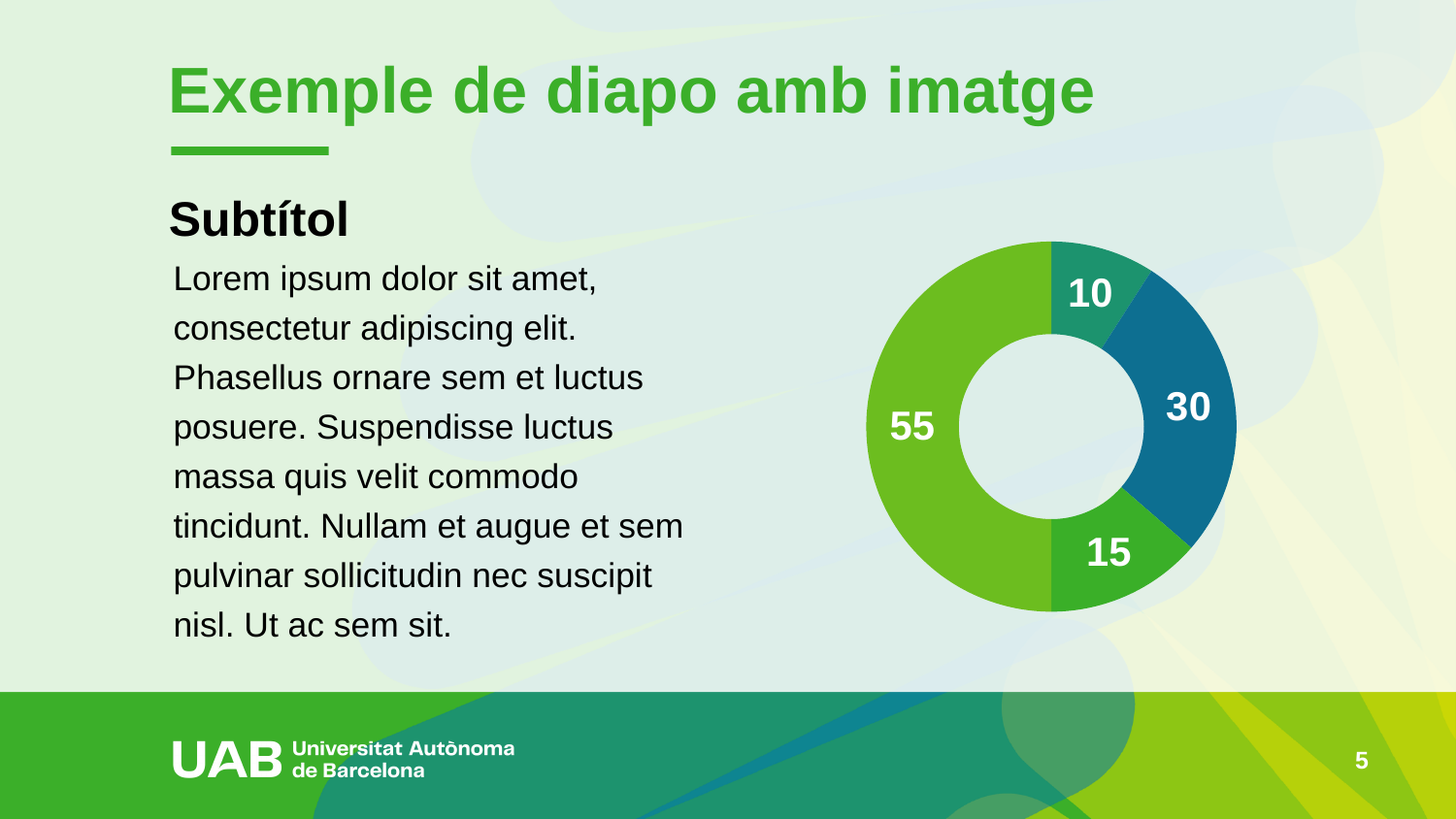
What is the smallest value shown in the doughnut chart? 10 What value is shown on the slice at the bottom of the doughnut chart? 15 How many slices does the doughnut chart have? 4 What value is shown on the teal (dark blue-green) slice of the doughnut chart? 30 What is the total of all the values shown in the doughnut chart? 110 What kind of chart is shown on the slide? Doughnut chart Which is larger, the teal slice or the bottom green slice? The teal slice (30) What is the difference between the largest slice (55) and the teal slice (30)? 25 What share of the total does the slice labelled 55 represent? 50% What is the difference between the slice labelled 15 and the slice labelled 10? 5 What is the largest value shown in the doughnut chart? 55 What value is shown on the light green slice on the left side of the doughnut chart? 55